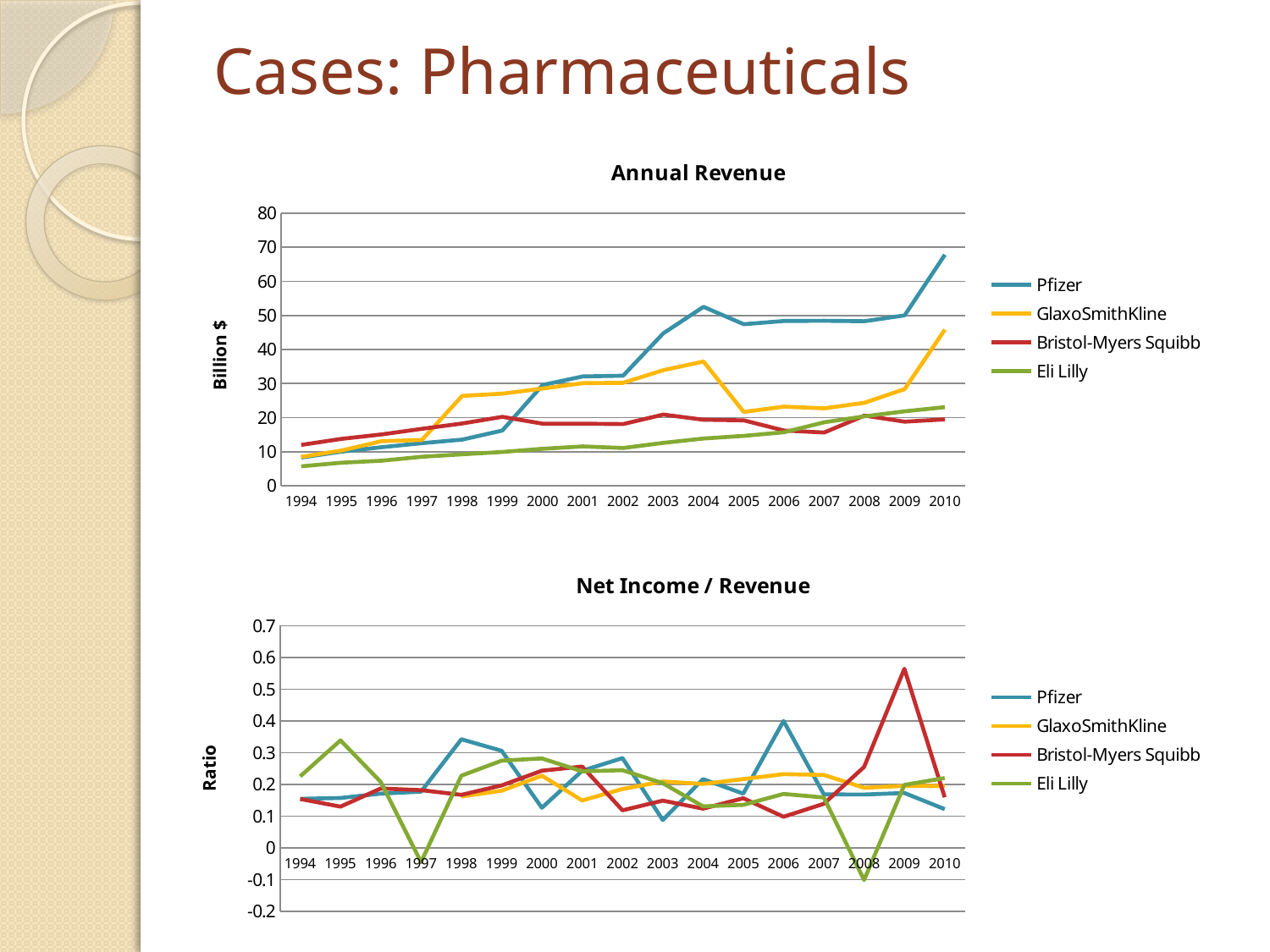
In the Annual Revenue chart, is the value for GlaxoSmithKline in 2010 greater or less than 40? greater In the Net Income / Revenue chart, is the value for Bristol-Myers Squibb in 2009 greater or less than 0.5? greater How many series does the legend of the Annual Revenue chart list? 4 In the Annual Revenue chart, is the value for Pfizer in 2010 greater or less than 60? greater How many years are shown on the x axis of the Annual Revenue chart? 17 In the Annual Revenue chart, which company has the lowest revenue in 1994? Eli Lilly In the Net Income / Revenue chart, which is larger in 2008, the value for Pfizer or the value for Eli Lilly? Pfizer In the Annual Revenue chart, which company has the highest revenue in 2010? Pfizer What is the y-axis label of the Annual Revenue chart? Billion $ In the Annual Revenue chart, does Eli Lilly's revenue generally rise or fall from 1994 to 2010? rise In the Net Income / Revenue chart, which company has the highest ratio in 2009? Bristol-Myers Squibb What kind of chart is the Annual Revenue chart? line chart